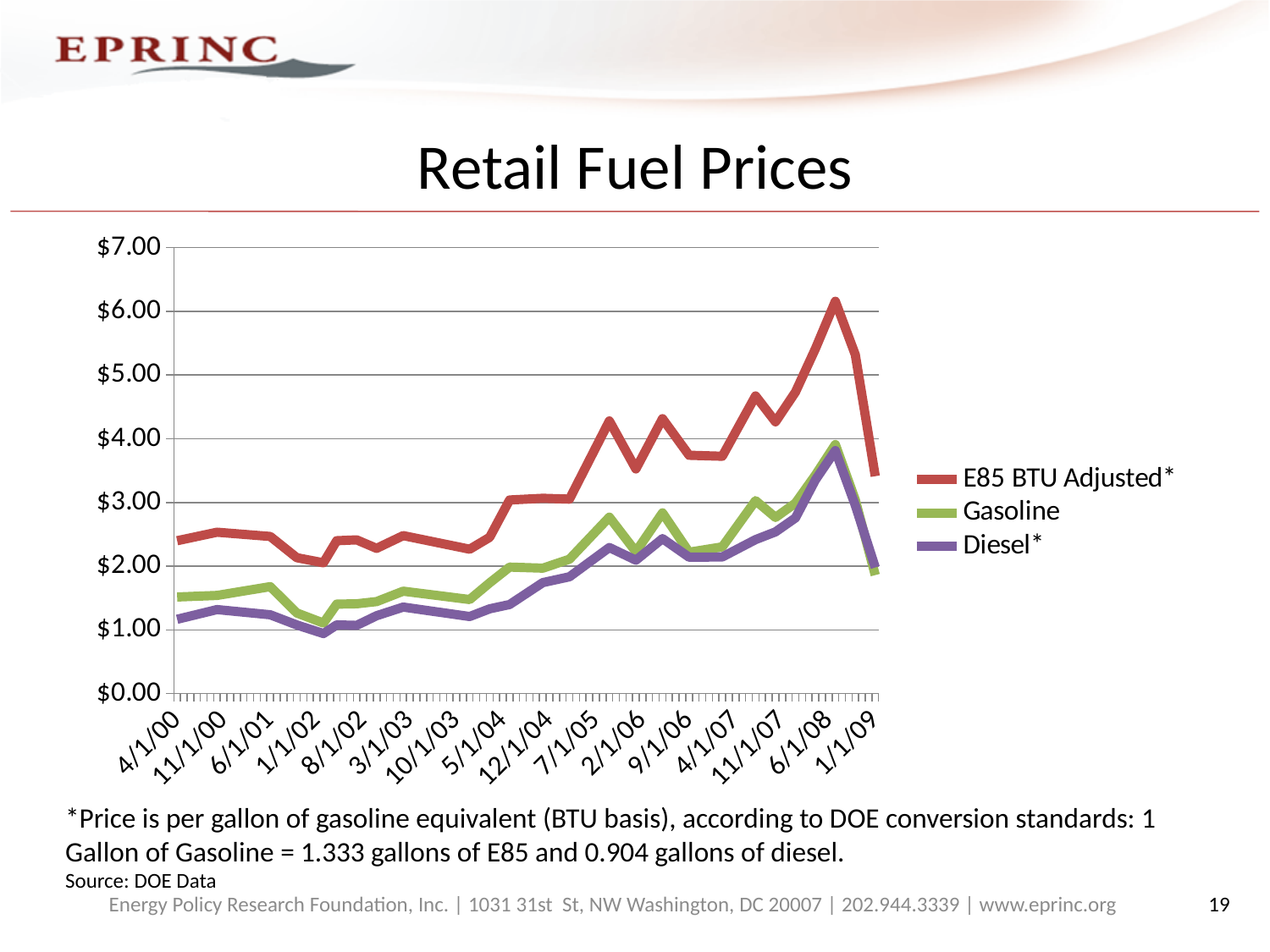
What kind of chart is shown on the slide? line chart How many series does the legend list? 3 Is the Gasoline value at 4/1/00 greater or less than $2.00? less Is the Gasoline value at 6/1/08 greater or less than $3.00? greater Which series has the highest values across the whole period? E85 BTU Adjusted* Around which x-axis date does the E85 BTU Adjusted* series reach its peak? 6/1/08 Is the E85 BTU Adjusted* value at 1/1/09 greater or less than $3.00? greater What is the title of the chart? Retail Fuel Prices Which series has the lowest values across the whole period? Diesel* Do the Gasoline prices generally rise or fall from 4/1/00 to 6/1/08? rise Which series is shown in red in the chart? E85 BTU Adjusted*